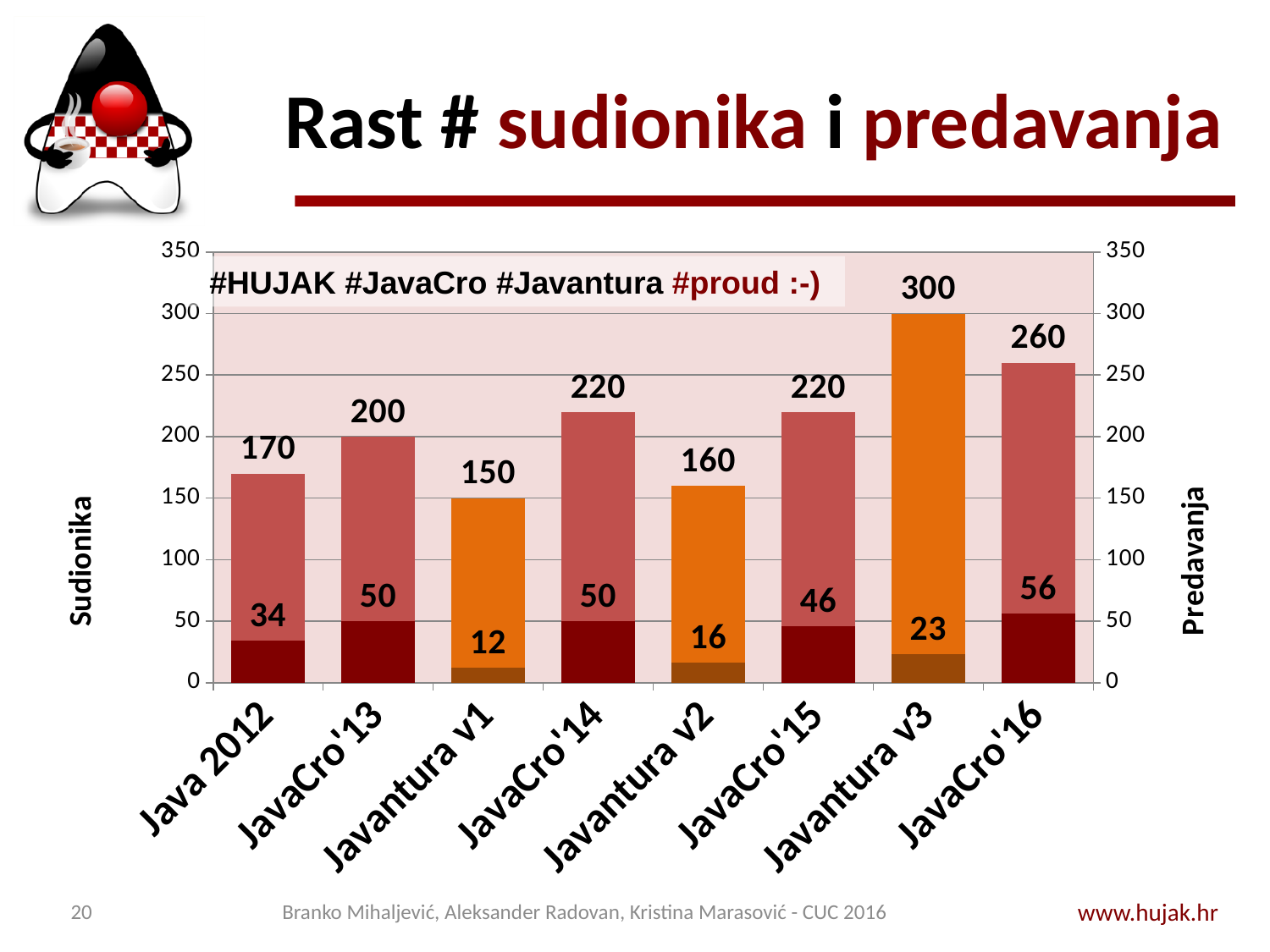
What is the label of the left vertical axis? Sudionika Which event has the highest number of Sudionika? Javantura v3 How many events (categories) are shown on the x axis? 8 What is the number of Sudionika for Java 2012? 170 What is the difference in Predavanja between JavaCro'16 and Java 2012? 22 What is the number of Predavanja (lectures) for JavaCro'16? 56 Which event has the lowest number of Predavanja? Javantura v1 What is the number of Sudionika (participants) for Javantura v3? 300 What is the difference in Sudionika between JavaCro'16 and JavaCro'15? 40 What kind of chart is shown on the slide? Bar chart What is the number of Predavanja for Javantura v1? 12 Which has more Predavanja, JavaCro'15 or Javantura v3? JavaCro'15